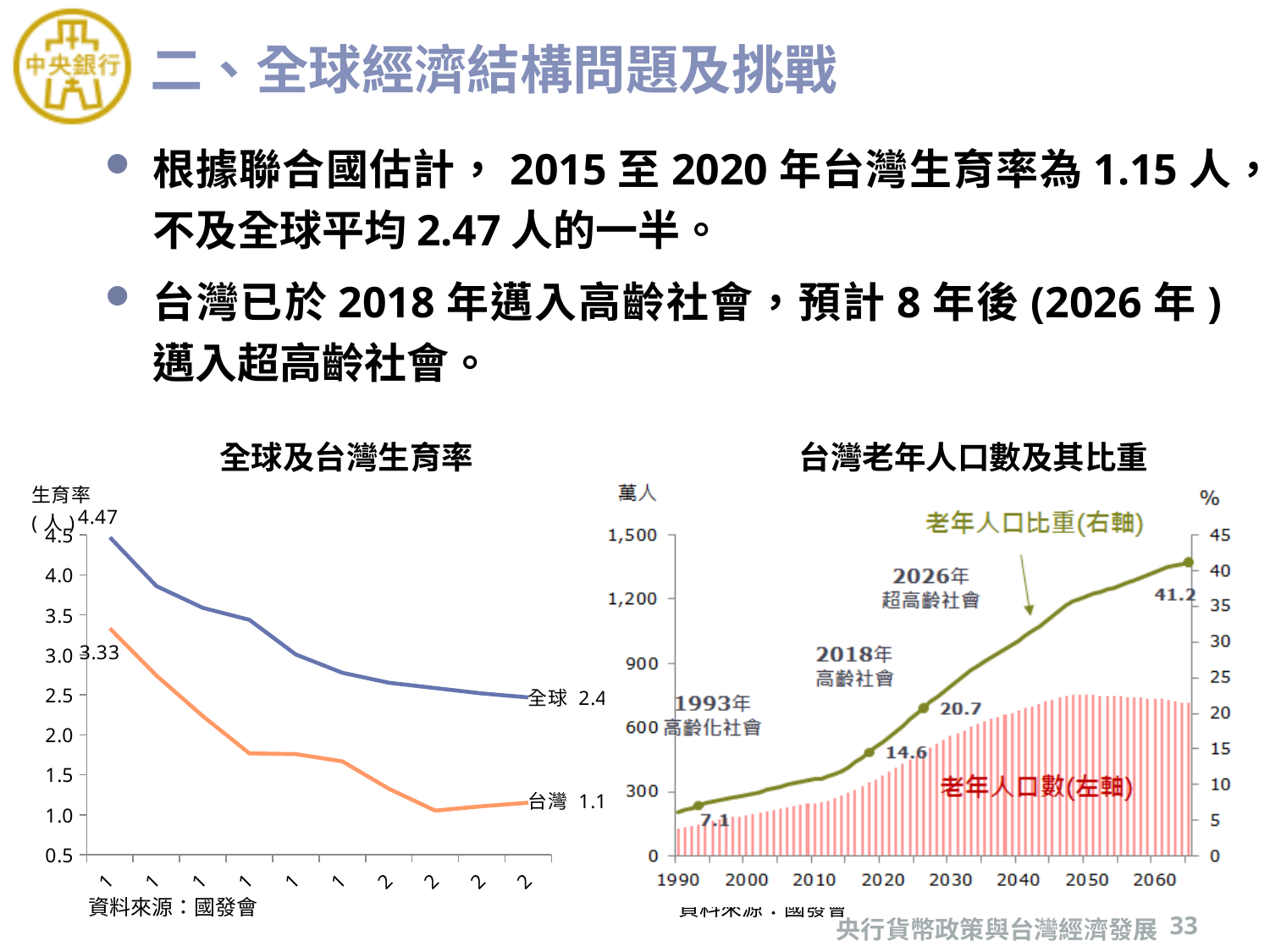
In the left chart 全球及台灣生育率, what is the first labelled value of the 台灣 series? 3.33 In the left chart 全球及台灣生育率, what is the final labelled value of the 台灣 series? 1.1 In the right chart 台灣老年人口數及其比重, what is the difference between the 老年人口比重 labels for 2026年 (20.7) and 2018年 (14.6)? 6.1 In the left chart 全球及台灣生育率, what is the difference between the first labelled values of 全球 (4.47) and 台灣 (3.33)? 1.14 In the left chart 全球及台灣生育率, which series ends higher, 全球 or 台灣? 全球 In the right chart 台灣老年人口數及其比重, is the 老年人口數 value around 2050 greater or less than 600 萬人? greater In the left chart 全球及台灣生育率, what is the first labelled value of the 全球 series? 4.47 What kind of chart is the left chart titled 全球及台灣生育率? line chart In the left chart 全球及台灣生育率, do the fertility rates rise or fall over time? fall In the right chart 台灣老年人口數及其比重, what is the labelled 老年人口比重 value for 2026年? 20.7 In the left chart 全球及台灣生育率, how many series are plotted? 2 In the right chart 台灣老年人口數及其比重, what is the labelled 老年人口比重 value for 1993年? 7.1